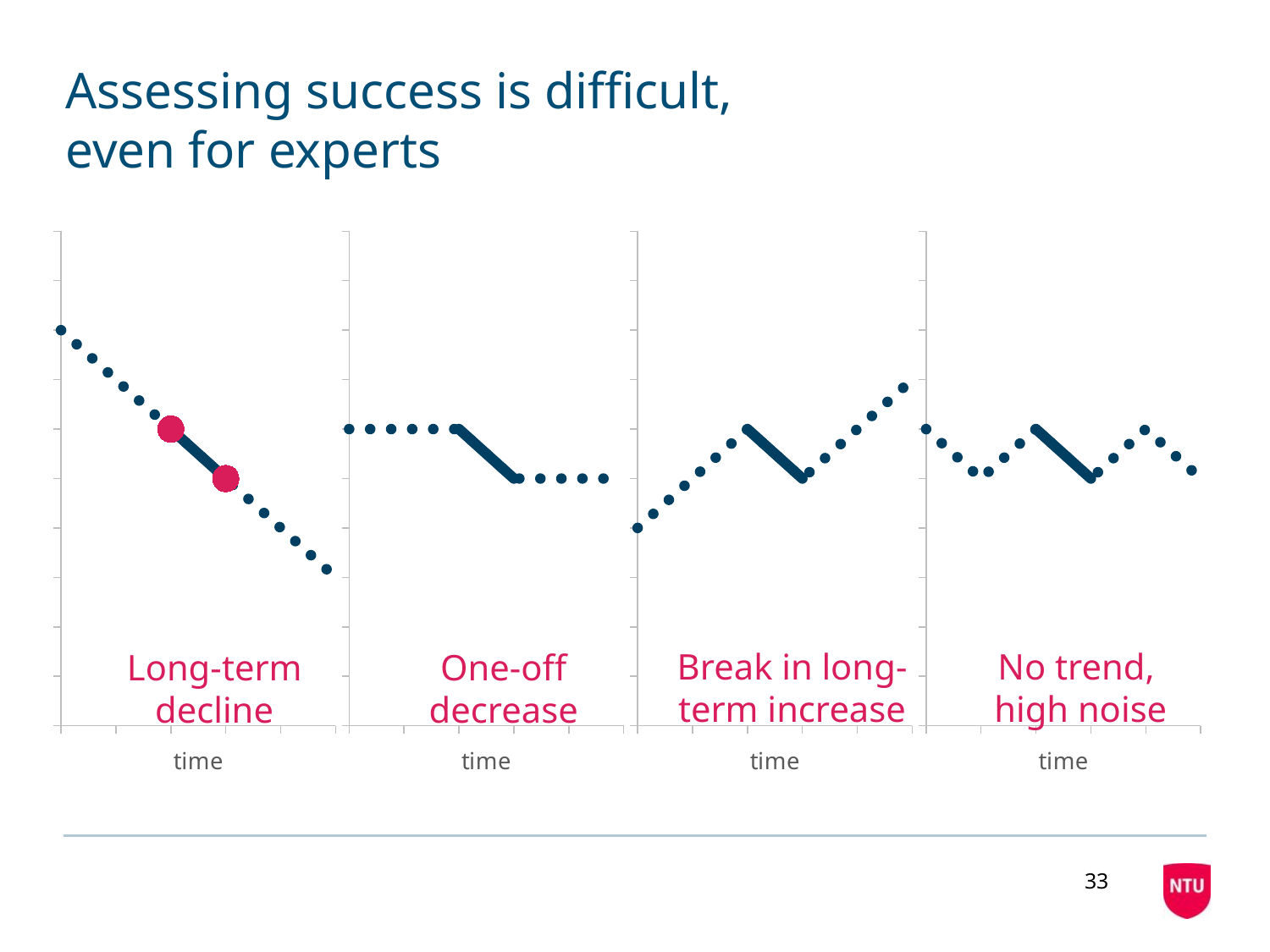
In the chart labelled 'One-off decrease', is the level of the points after the drop higher or lower than the level before it? lower How many charts are shown on the slide? 4 In the chart labelled 'Long-term decline', do the values rise or fall along the x axis? fall Are the charts on the slide bar charts, pie charts or line charts? line charts In the chart labelled 'Break in long-term increase', is the last point higher or lower than the first point? higher How many large pink circles are highlighted on the 'Long-term decline' chart? 2 In the chart labelled 'Long-term decline', is the first point higher or lower than the last point? higher What is the label of the second chart from the left? One-off decrease What is the label of the fourth (rightmost) chart? No trend, high noise In the chart labelled 'Break in long-term increase', do the values overall rise or fall from the first point to the last? rise What label appears on the x axis of each chart? time